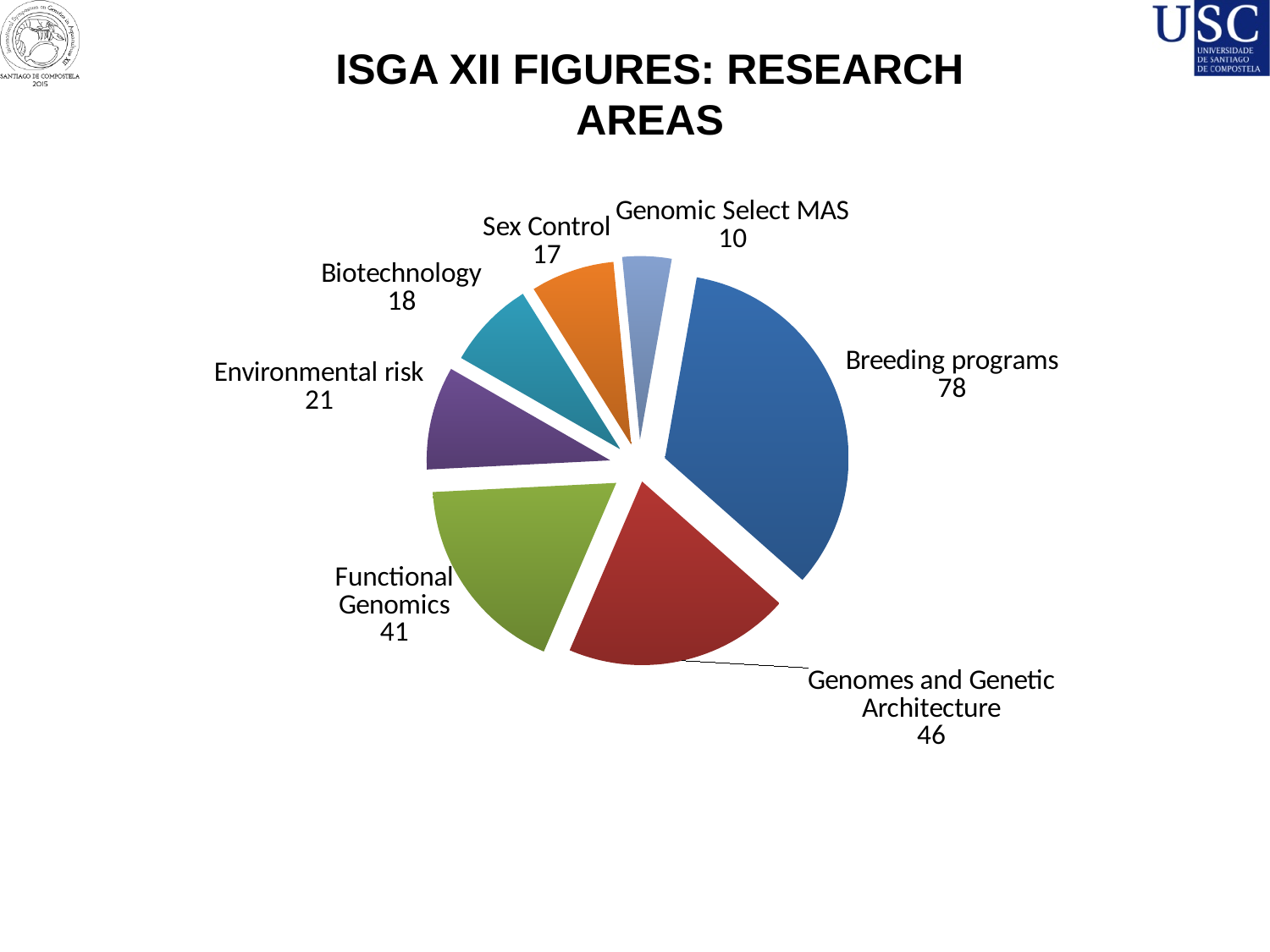
What is the difference between Breeding programs and Genomes and Genetic Architecture? 32 What type of chart is shown on the slide? Pie chart What is the value for Genomes and Genetic Architecture? 46 How many research areas are shown in the pie chart? 7 What is the value for Functional Genomics? 41 What is the value for Environmental risk? 21 Which research area has the smallest slice? Genomic Select MAS What is the value for Breeding programs? 78 Which is larger, Biotechnology or Sex Control? Biotechnology What is the value for Genomic Select MAS? 10 What is the title of the slide containing the chart? ISGA XII FIGURES: RESEARCH AREAS Which research area has the largest slice? Breeding programs